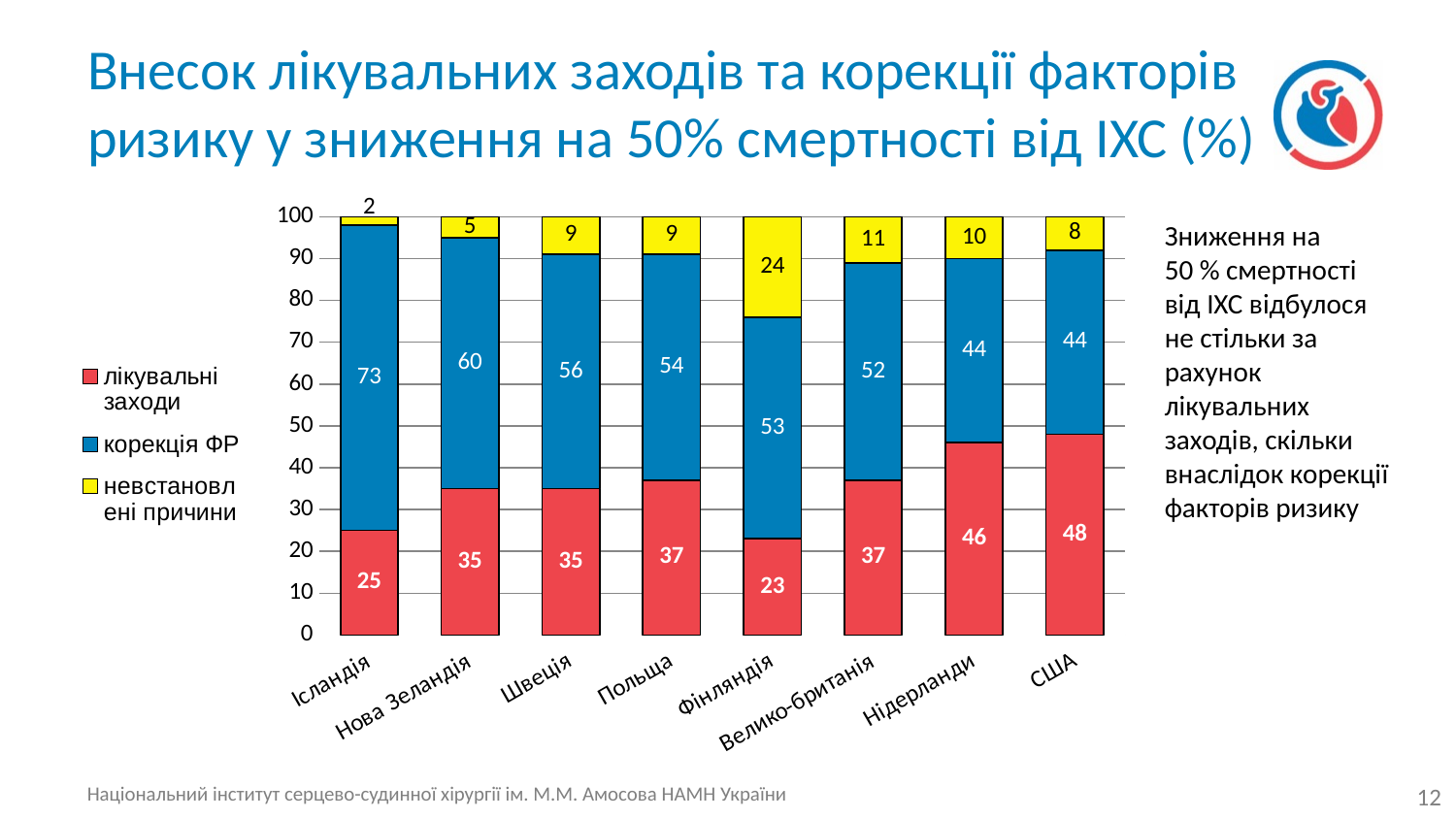
How many countries are shown on the x axis? 8 Which country has the lowest value for "корекція ФР"? Нідерланди and США (both 44) What is the total of the stacked bar for Швеція? 100 What is the value of "лікувальні заходи" for Ісландія? 25 How many series does the legend list? 3 Which is larger: "лікувальні заходи" for Нідерланди or for Польща? Нідерланди What is the difference between the "корекція ФР" values for Ісландія and Нова Зеландія? 13 Which country has the highest value for "невстановлені причини"? Фінляндія What is the value of "невстановлені причини" for Велико-британія? 11 What is the value of "корекція ФР" for Фінляндія? 53 What kind of chart is shown on the slide? Stacked bar chart Which country has the highest value for "лікувальні заходи"? США